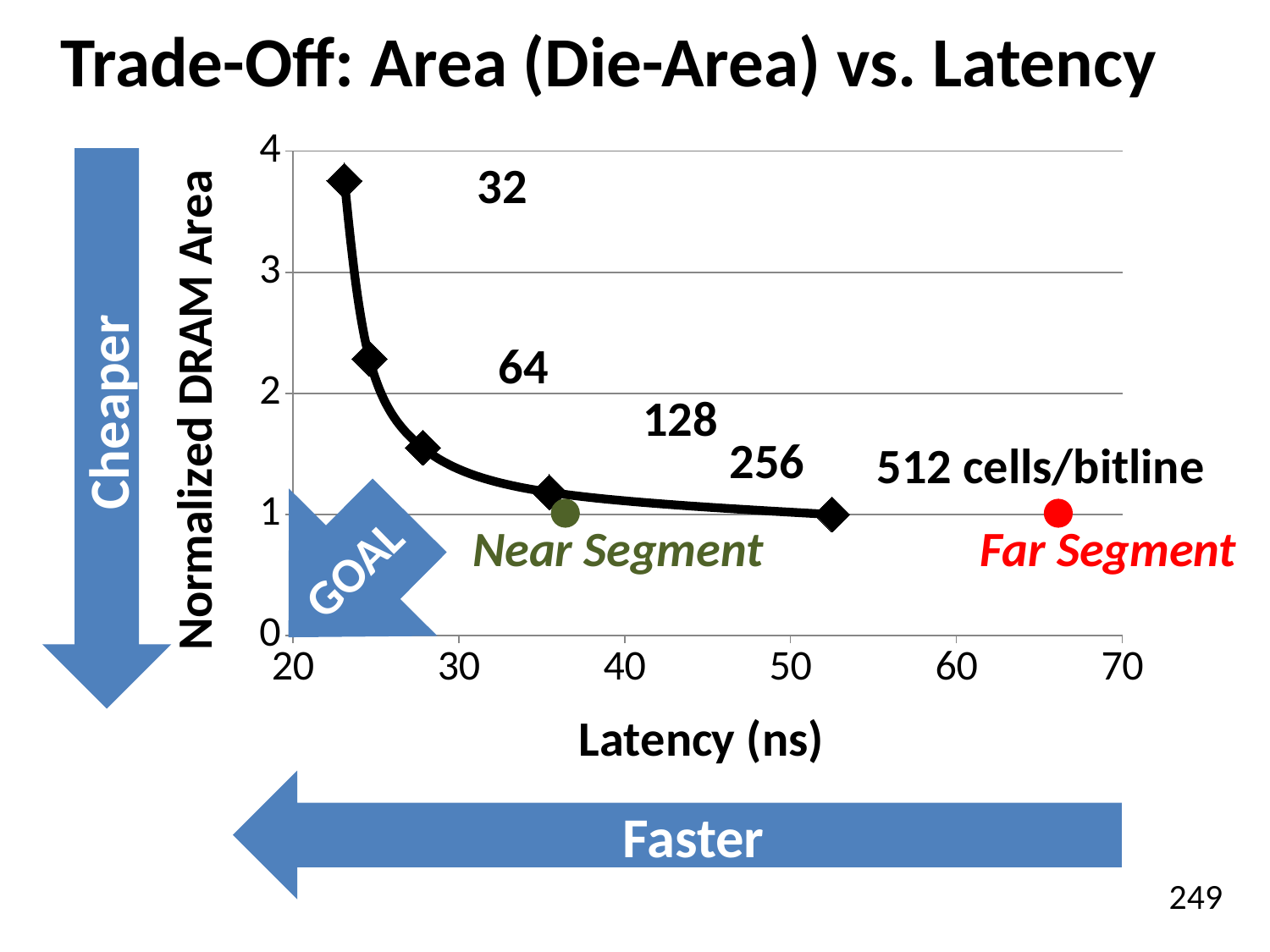
Is the latency for 512 cells/bitline greater or less than 50 ns? greater Is the normalized DRAM area for 32 cells/bitline greater or less than 3? greater Which has the higher normalized DRAM area, 128 cells/bitline or 256 cells/bitline? 128 cells/bitline As latency increases along the x axis, does the normalized DRAM area rise or fall? fall What kind of chart is shown on the slide? line chart Is the normalized DRAM area for 64 cells/bitline greater or less than 2? greater Which cells/bitline configuration has the highest normalized DRAM area? 32 What is the title of the chart on the slide? Trade-Off: Area (Die-Area) vs. Latency What is the label of the x axis? Latency (ns) Which cells/bitline configuration has the lowest normalized DRAM area? 512 How many black diamond data points are plotted on the curve? 5 Which cells/bitline configuration has the highest latency? 512